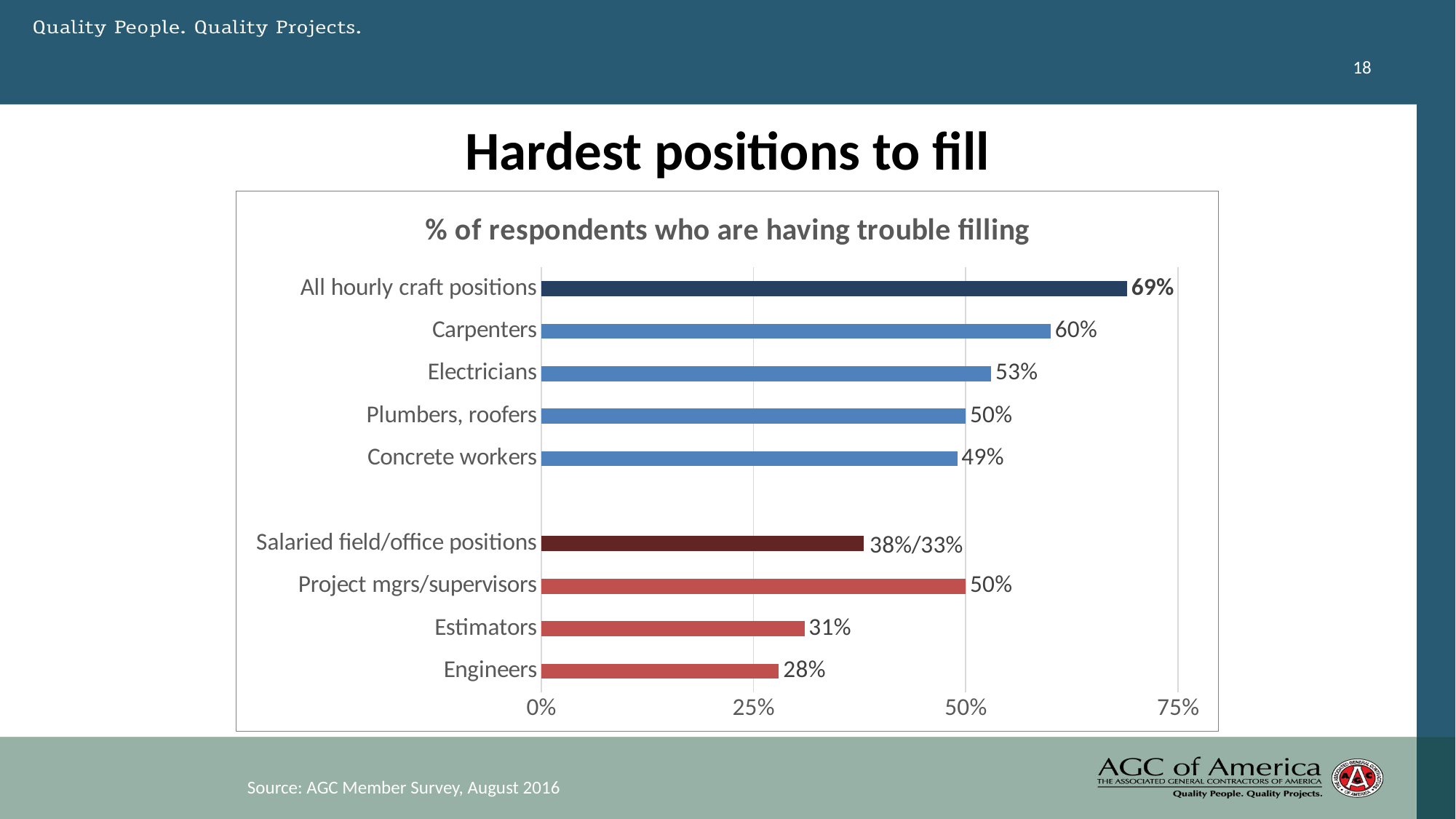
Which is larger, the value for Electricians or the value for Concrete workers? Electricians What is the title of the chart? % of respondents who are having trouble filling How many categories are shown on the chart? 9 Which category has the highest value? All hourly craft positions What is the value for Engineers? 28% Which category has the lowest value? Engineers What is the difference between the values for All hourly craft positions and Carpenters? 9% What is the value for Carpenters? 60% What is the value for Electricians? 53% What is the difference between the values for Estimators and Engineers? 3% What label is printed next to the bar for Salaried field/office positions? 38%/33% What kind of chart is shown on the slide? Bar chart